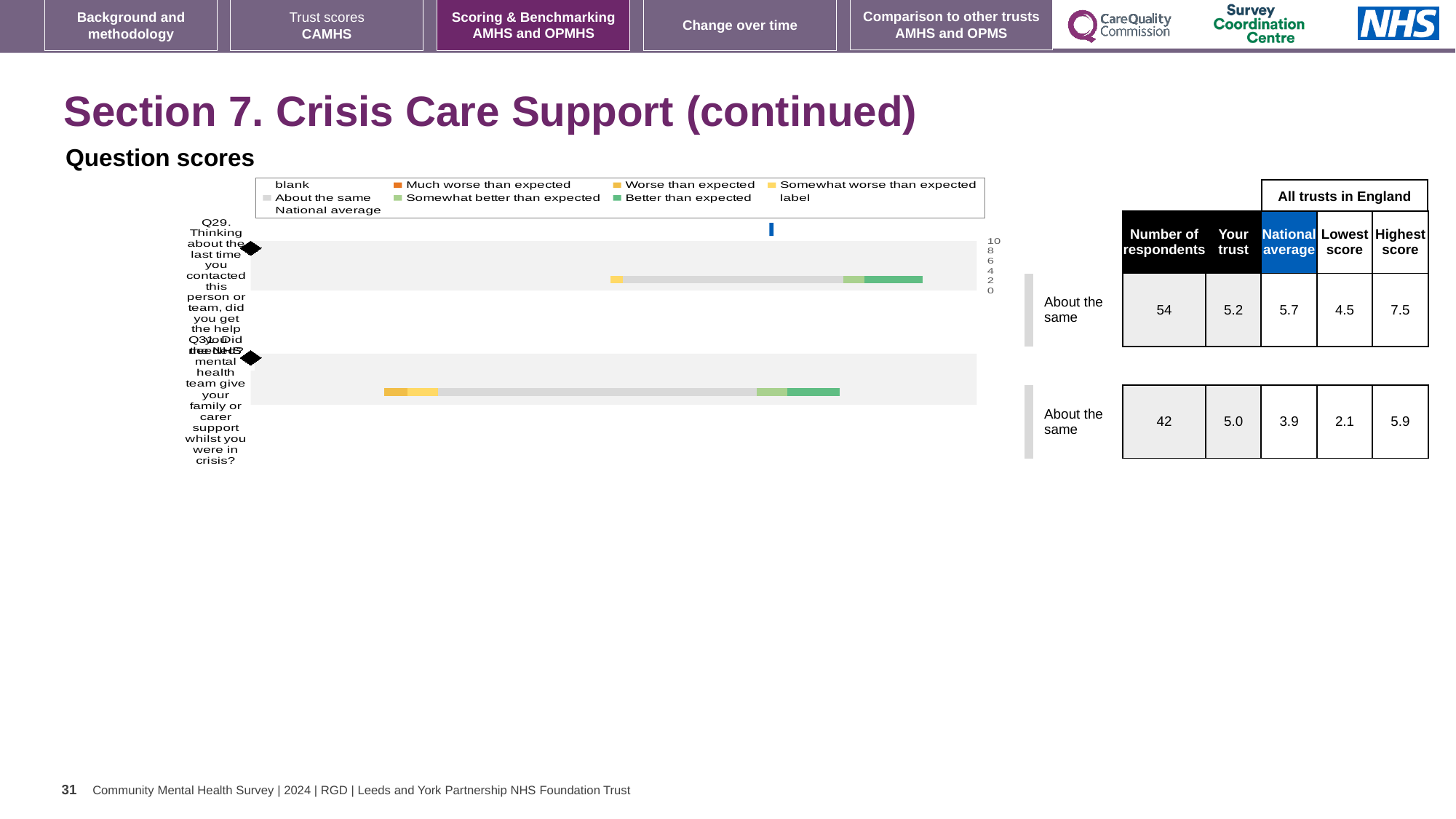
For Q31, which is larger: the 'Your trust' score or the national average? Your trust In the legend of the question scores chart, what colour represents 'Much worse than expected'? orange In the table beside the chart, what is the highest score for Q31? 5.9 For Q29, which is larger: the 'Your trust' score or the national average? National average How many questions (bars) are plotted in the question scores chart? 2 For Q31, what is the difference between the highest score and the lowest score shown in the table? 3.8 How many entries does the legend of the question scores chart list? 9 What kind of chart is used to show the question scores for Q29 and Q31? bar chart In the table beside the chart, what is the 'Your trust' score for Q29? 5.2 In the table beside the chart, how many respondents are recorded for Q29? 54 In the table beside the chart, what is the national average score for Q31? 3.9 What heading appears directly above the question scores chart? Question scores